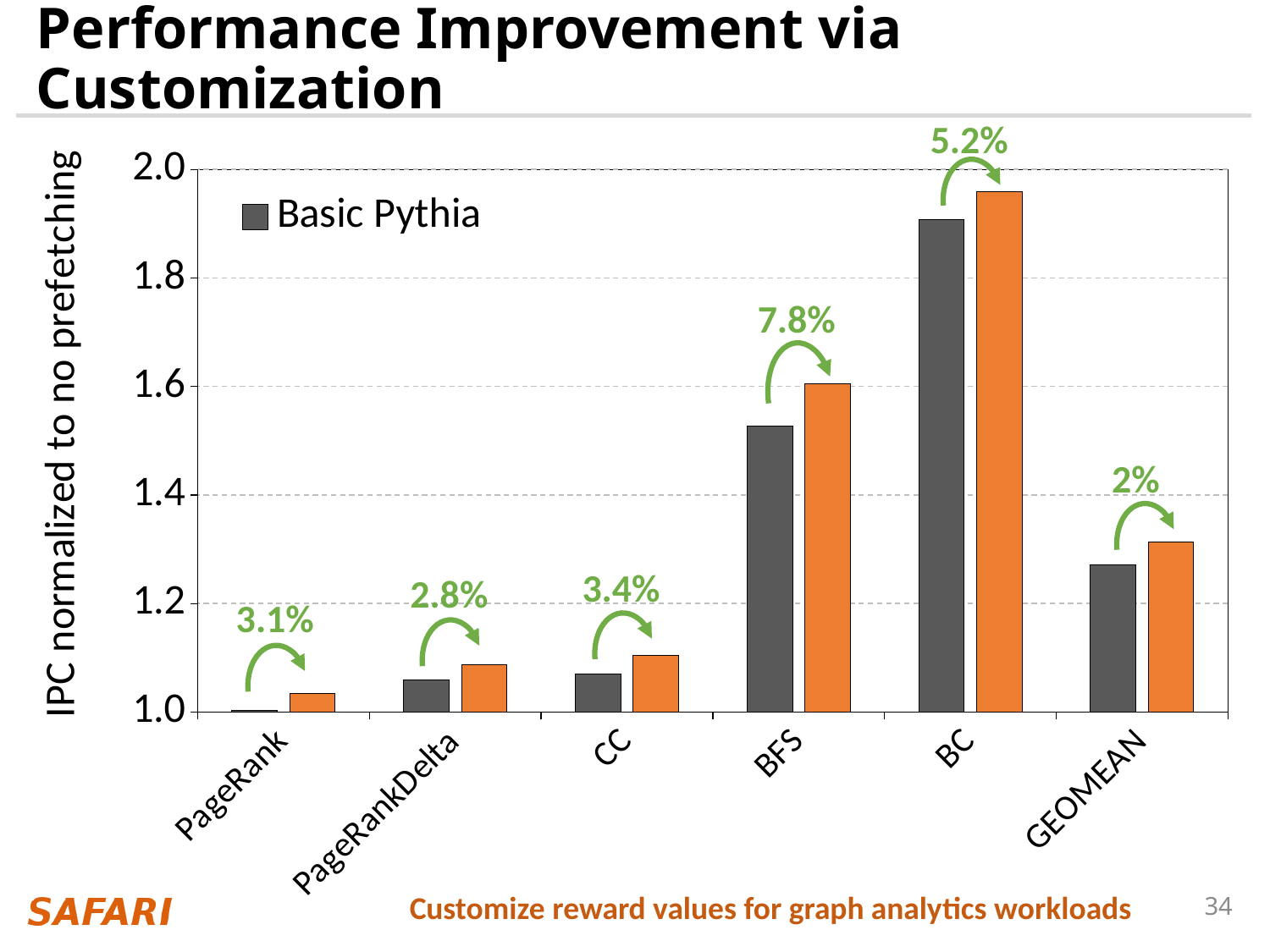
What is the y-axis label of the chart? IPC normalized to no prefetching Which category has the highest IPC bars? BC What is the percentage improvement annotated above the PageRankDelta bars? 2.8% Which category has the lowest IPC bars? PageRank What is the percentage improvement annotated above the BFS bars? 7.8% What kind of chart is shown on the slide? bar chart How many series does the legend list? 1 What is the percentage improvement annotated above the GEOMEAN bars? 2% Is the Basic Pythia value for BFS greater or less than 1.6? less Which category has the largest annotated percentage improvement? BFS How many categories are shown on the x axis? 6 Is the Basic Pythia value for BC greater or less than 1.8? greater